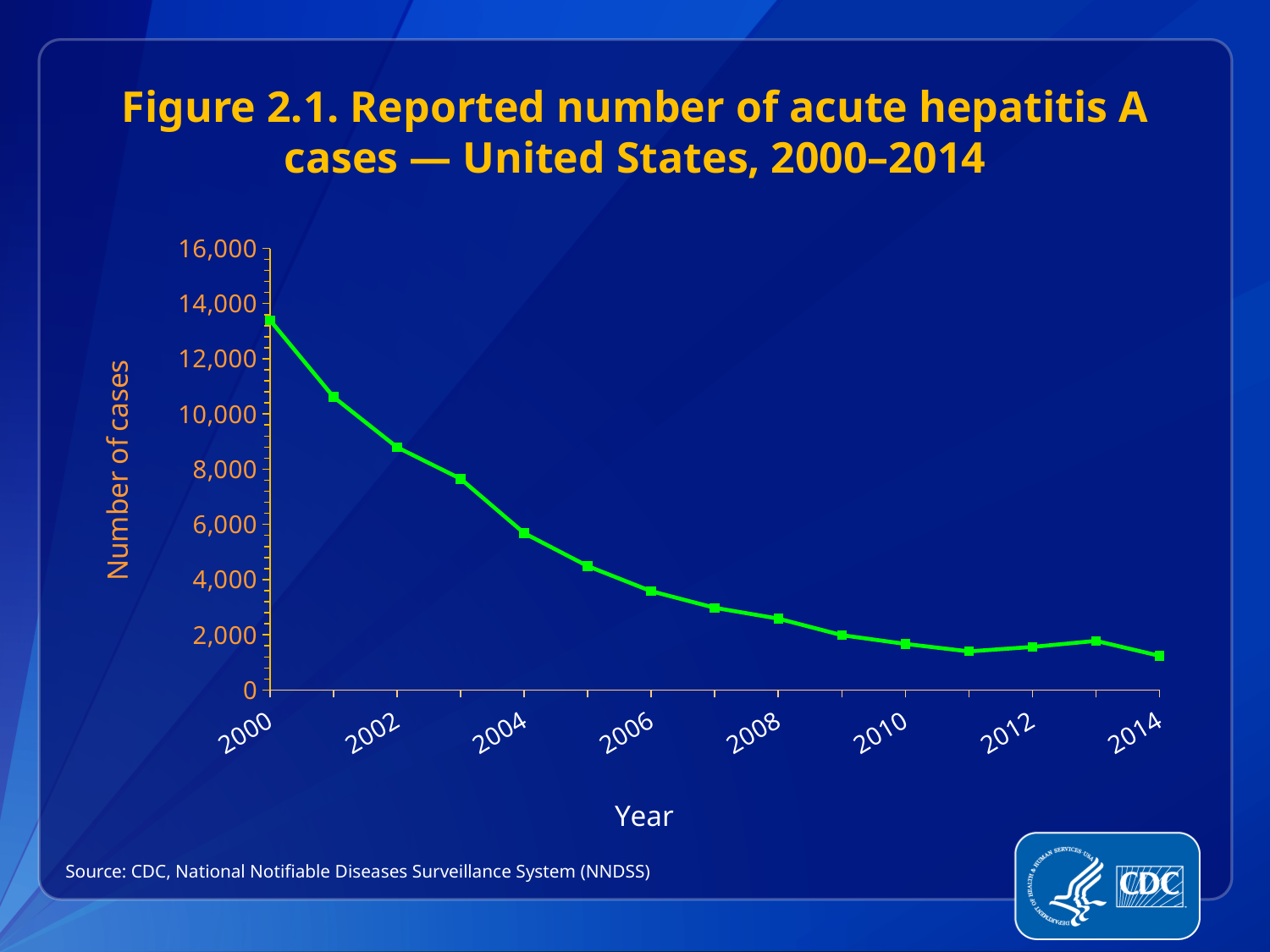
Is the value for 2010 greater or less than 2,000? less Is the value for 2008 greater or less than 2,000? greater Which year has the highest reported number of acute hepatitis A cases? 2000 Do the reported cases generally rise or fall from 2000 to 2014? fall Is the value for 2000 greater or less than 12,000? greater Which year has more reported cases, 2005 or 2007? 2005 What is the label on the vertical axis? Number of cases What kind of chart is shown on the slide? line chart How many yearly data points are plotted on the line? 15 Which year has more reported cases, 2000 or 2014? 2000